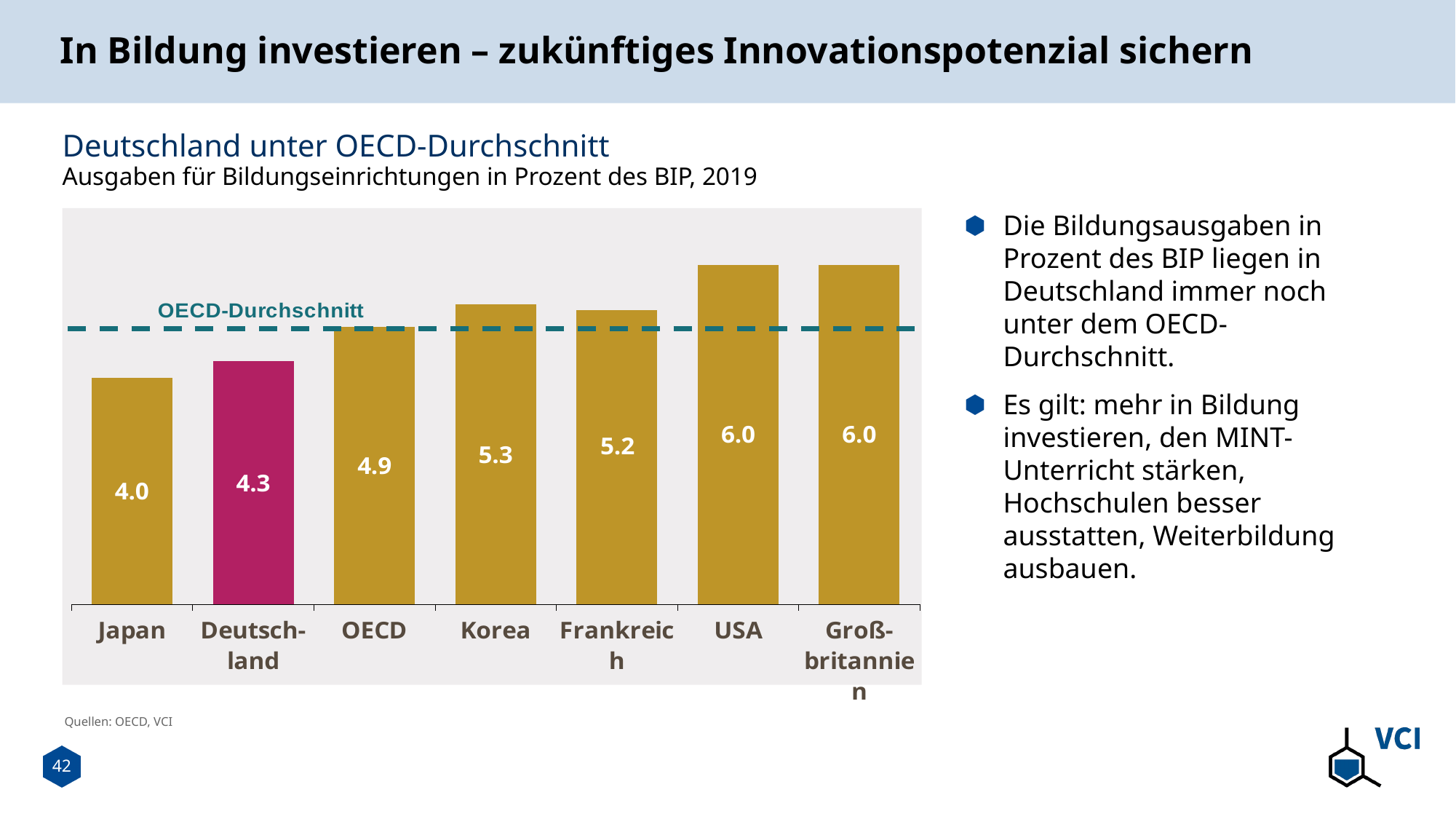
What is the difference between the values for USA and Japan? 2.0 Which is larger, the value for Japan or the value for Deutschland? Deutschland Which bar is highlighted in a different colour from the others? Deutschland What is the value for Korea? 5.3 How many categories are shown in the chart? 7 What kind of chart is shown on the slide? Bar chart What does the dashed horizontal line in the chart represent? OECD-Durchschnitt What is the value for Frankreich? 5.2 Which category has the lowest value? Japan Which is larger, the value for Korea or the value for Frankreich? Korea What is the value for Deutschland? 4.3 What is the difference between the values for OECD and Deutschland? 0.6